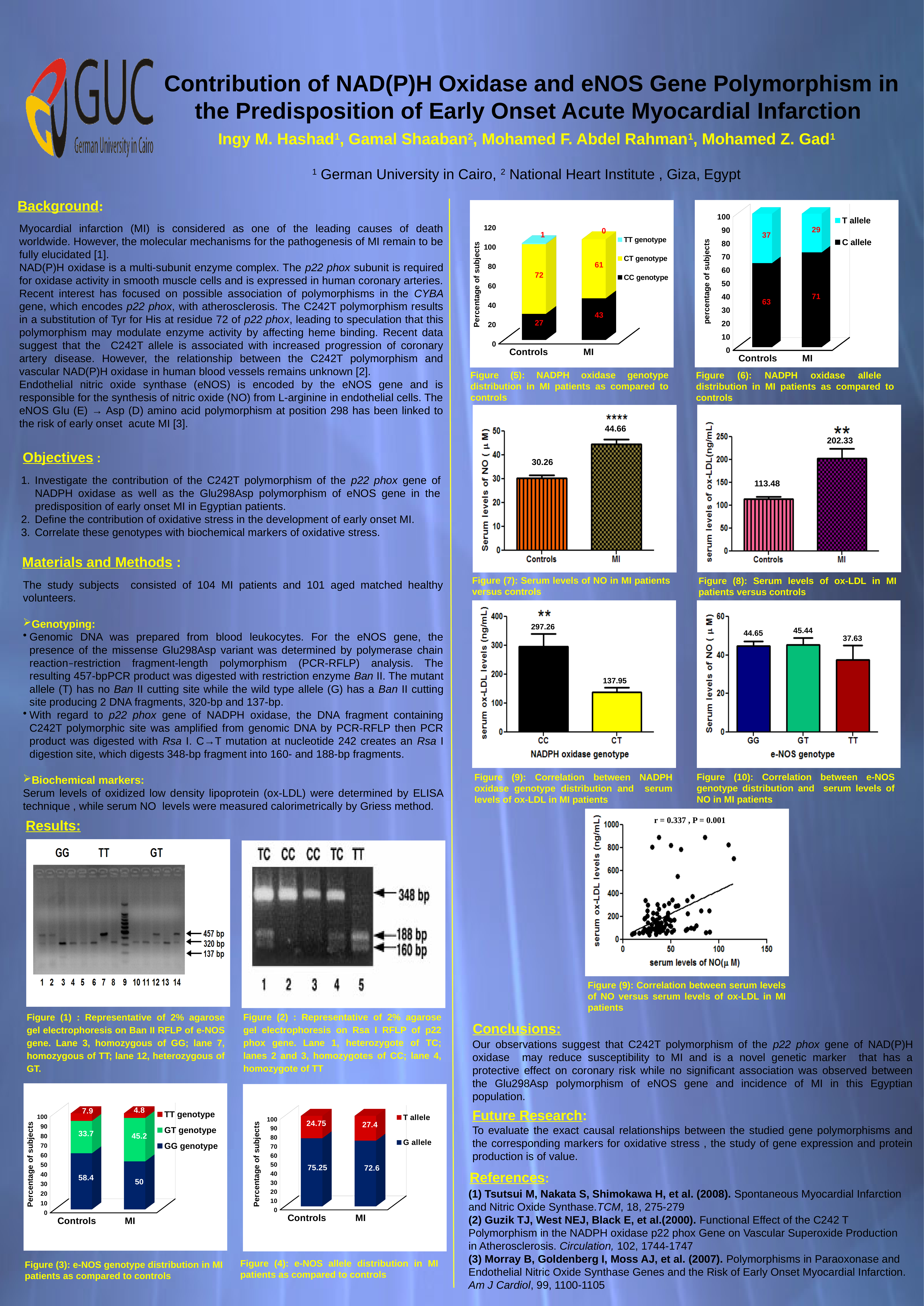
In Figure (9) (correlation between NADPH oxidase genotype and serum ox-LDL), which genotype has the higher ox-LDL level, CC or CT? CC In Figure (3) (e-NOS genotype distribution), what is the GT genotype value for MI? 45.2 In Figure (4) (e-NOS allele distribution), what is the T allele value for Controls? 24.75 In the scatter plot of serum ox-LDL versus serum NO (Figure (9)), what correlation coefficient r is printed on the chart? r = 0.337 In Figure (6) (NADPH oxidase allele distribution), what is the total of the stacked bar for Controls? 100 In Figure (10) (correlation between e-NOS genotype and serum NO), how many genotype categories are shown on the x axis? 3 In Figure (7) (serum levels of NO in MI patients versus controls), what is the value for MI? 44.66 In Figure (5) (NADPH oxidase genotype distribution), what is the CC genotype value for MI? 43 In Figure (8) (serum levels of ox-LDL in MI patients versus controls), what is the difference between the MI and Controls values? 88.85 What kind of chart is Figure (9) showing serum ox-LDL levels versus serum levels of NO in MI patients? Scatter plot In Figure (3) (e-NOS genotype distribution), how many series does the legend list? 3 In Figure (10) (correlation between e-NOS genotype and serum NO), which genotype has the lowest serum NO level? TT